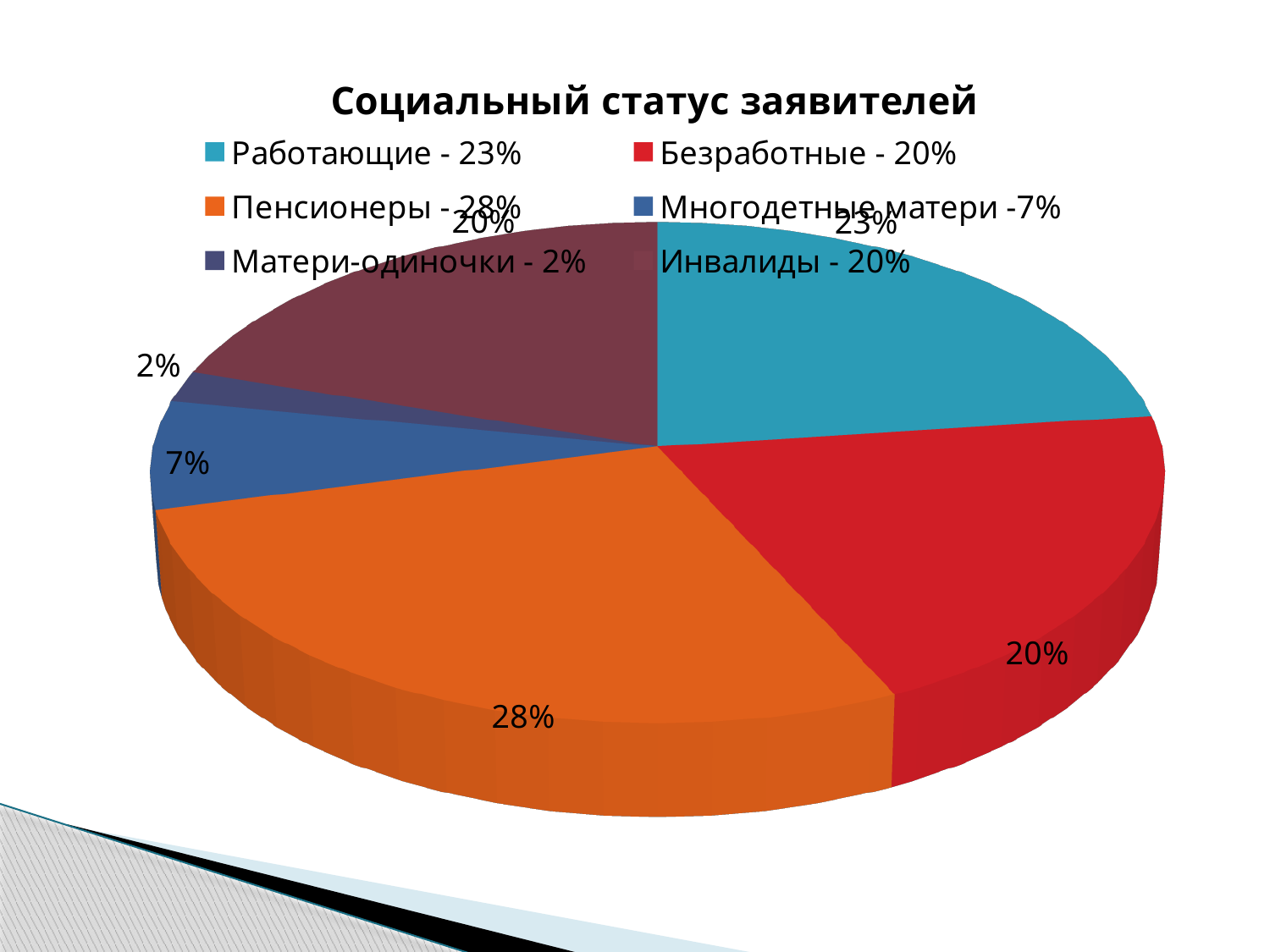
Which category has the largest slice of the pie? Пенсионеры What share of the pie is labelled for Пенсионеры? 28% What is the combined share of Безработные and Инвалиды? 40% What share of the pie is labelled for Многодетные матери? 7% How many categories does the pie chart have? 6 What share of the pie is labelled for Матери-одиночки? 2% What share of the pie is labelled for Работающие? 23% What is the difference between the shares for Пенсионеры and Безработные? 8% What is the title of the chart? Социальный статус заявителей Which is larger, the share for Работающие or the share for Инвалиды? Работающие Which category has the smallest slice of the pie? Матери-одиночки What type of chart is shown on the slide? pie chart